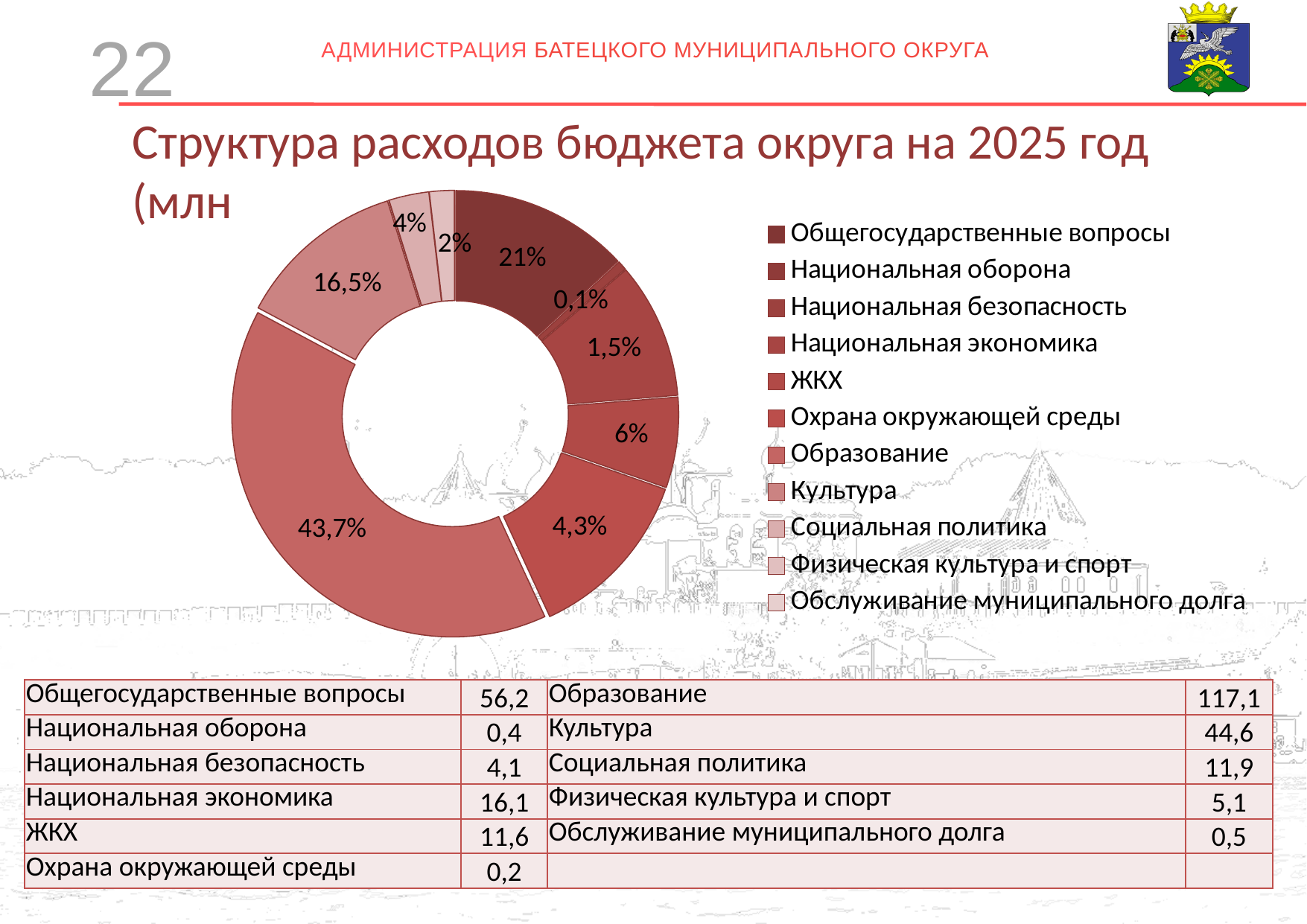
Which category has the largest share of the chart? Образование What kind of chart is shown on the slide? Pie (doughnut) chart What percentage is shown for Национальная экономика? 6% How many categories does the chart legend list? 11 By how many percentage points does the share of Образование exceed that of Общегосударственные вопросы? 22,7 What share of the budget expenditure does Образование account for? 43,7% What percentage is shown for Физическая культура и спорт? 2% What share of the chart is labelled for Общегосударственные вопросы? 21% What percentage is shown for Социальная политика? 4% Which has the larger share: Общегосударственные вопросы or Культура? Общегосударственные вопросы What percentage is shown for ЖКХ? 4,3% What percentage is shown for Культура? 16,5%